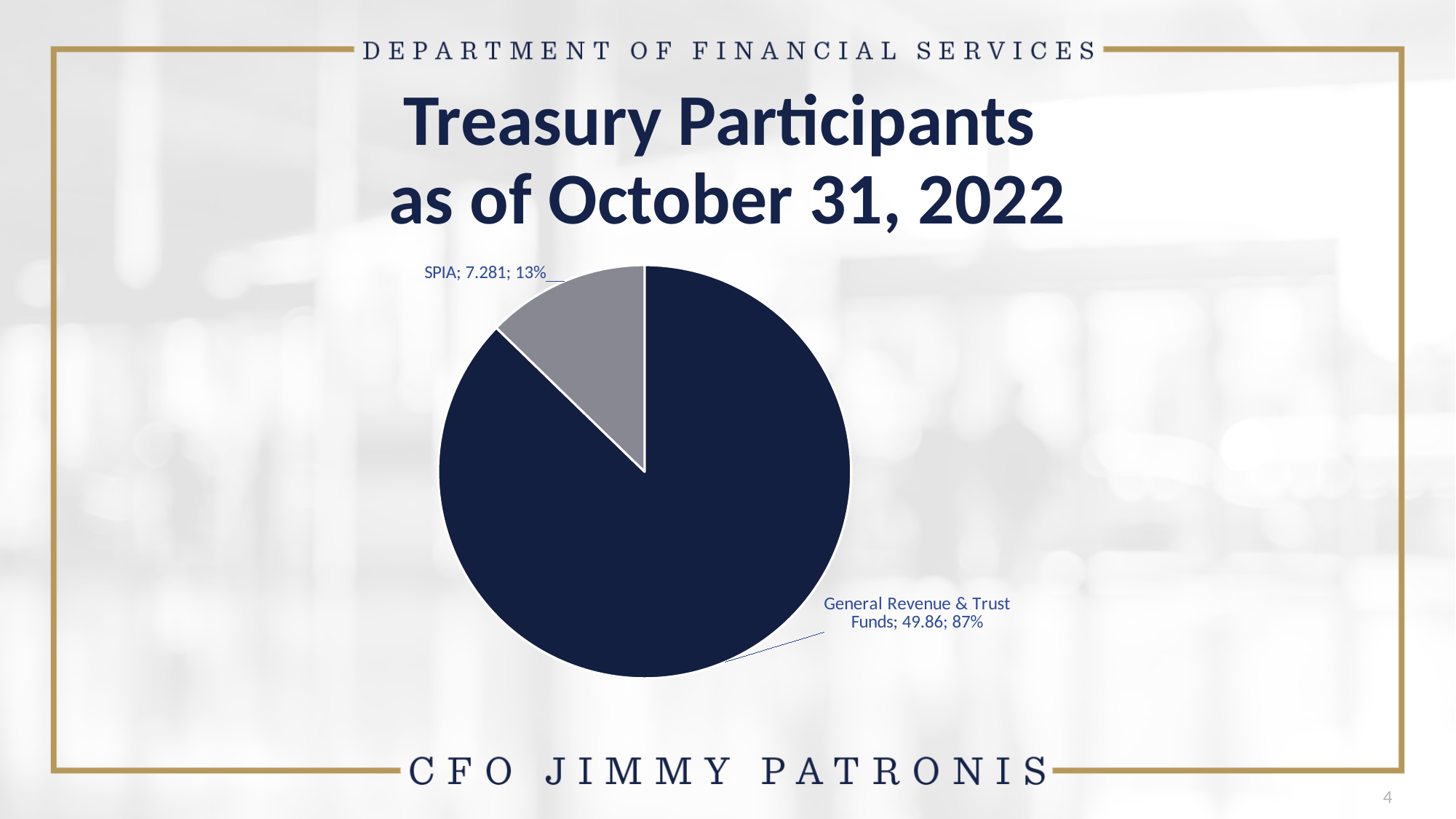
Which slice is the largest? General Revenue & Trust Funds Which slice is the smallest? SPIA What is the value for SPIA? 7.281 What share of the pie does SPIA represent? 13% What kind of chart is shown on the slide? pie chart What colour is the SPIA slice? grey What is the difference between the values for General Revenue & Trust Funds and SPIA? 42.579 How many slices does the pie chart have? 2 What share of the pie does General Revenue & Trust Funds represent? 87% Which is larger, SPIA or General Revenue & Trust Funds? General Revenue & Trust Funds What is the value for General Revenue & Trust Funds? 49.86 What is the title of the slide containing the chart? Treasury Participants as of October 31, 2022